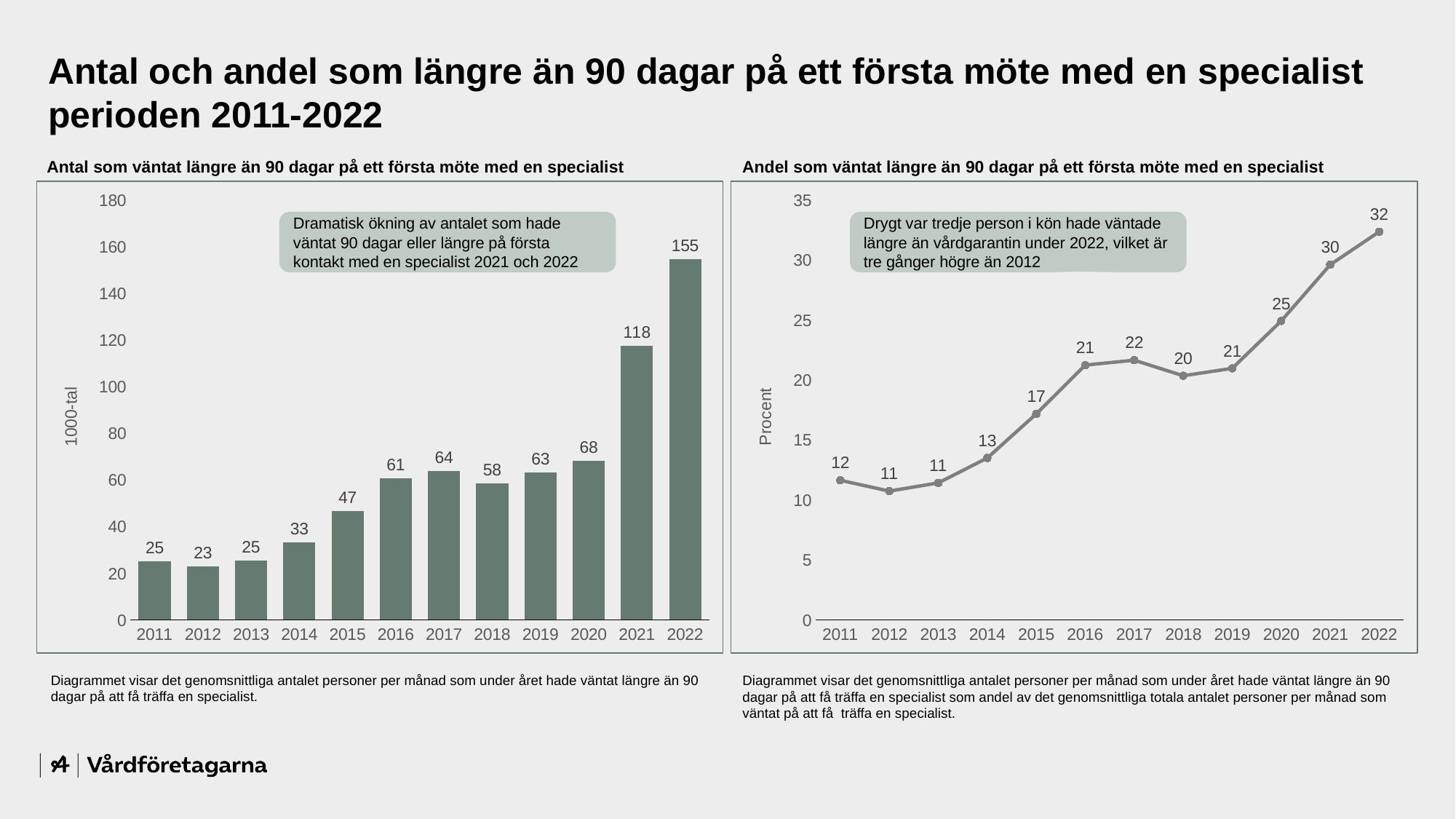
In the left chart (Antal som väntat längre än 90 dagar), what is the difference between the values for 2022 and 2021? 37 In the left chart (Antal som väntat längre än 90 dagar), which is larger, the value for 2017 or the value for 2018? 2017 In the right chart (Andel som väntat längre än 90 dagar), what is the difference between the values for 2022 and 2012? 21 In the right chart (Andel som väntat längre än 90 dagar), which year has the highest value? 2022 In the left chart (Antal som väntat längre än 90 dagar), what is the value for 2022? 155 In the right chart (Andel som väntat längre än 90 dagar), do the values generally rise or fall from 2013 to 2022? Rise What kind of chart is the right chart (Andel som väntat längre än 90 dagar)? Line chart In the left chart (Antal som väntat längre än 90 dagar), which year has the lowest value? 2012 In the left chart (Antal som väntat längre än 90 dagar), how many years are shown on the x axis? 12 In the right chart (Andel som väntat längre än 90 dagar), what is the value for 2016? 21 What kind of chart is the left chart (Antal som väntat längre än 90 dagar)? Bar chart What is the y-axis label of the right chart (Andel som väntat längre än 90 dagar)? Procent